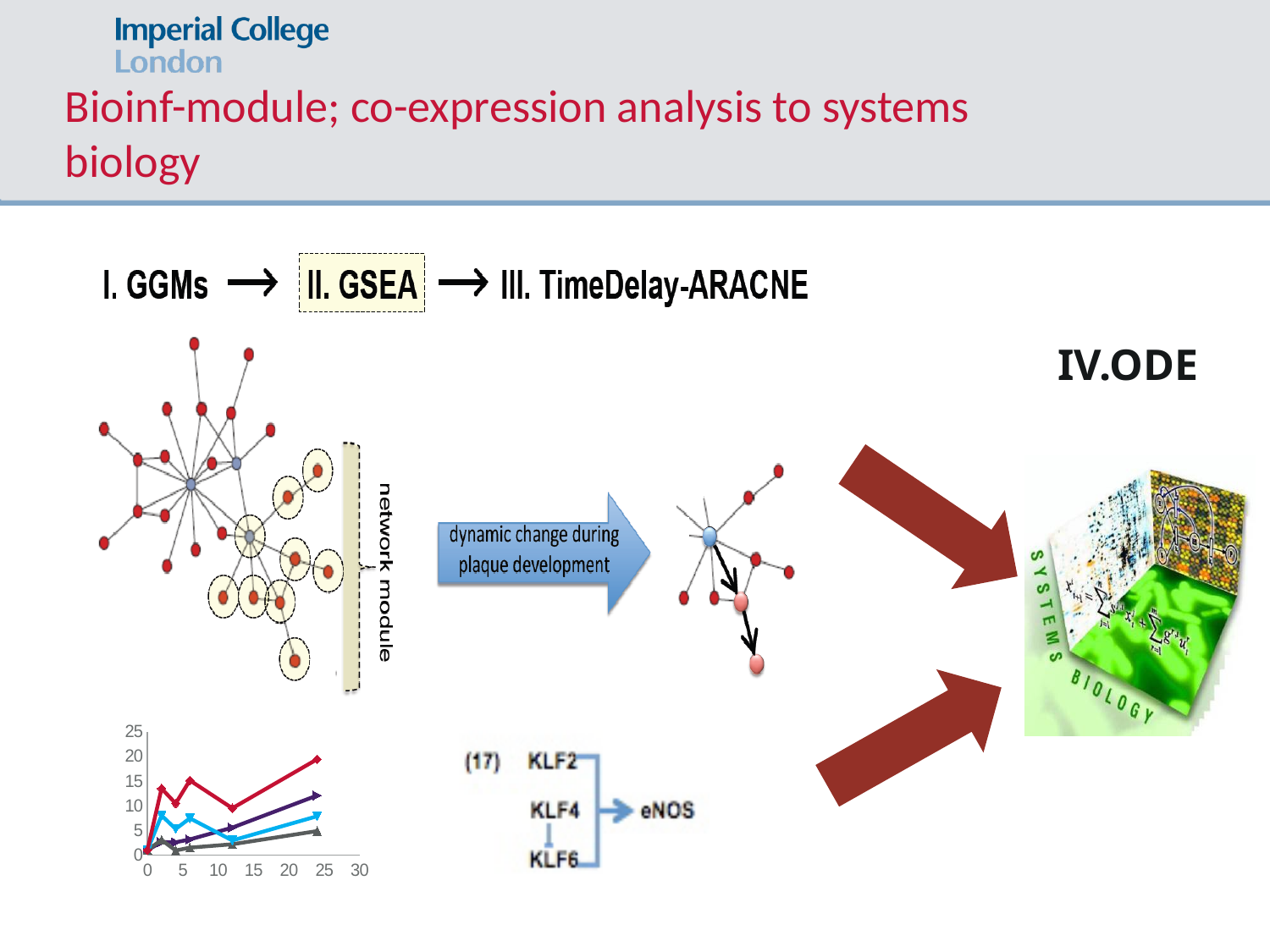
In the bottom-left line chart, is the final value of the purple line greater or less than 5? greater What is the highest tick value shown on the y axis of the bottom-left line chart? 25 In the bottom-left line chart, does the purple line rise or fall overall from left to right? rise What is the highest tick value shown on the x axis of the bottom-left line chart? 30 How many lines are plotted in the chart at the bottom left of the slide? 4 In the bottom-left line chart, is the final value of the red line greater or less than 15? greater In the bottom-left line chart, which coloured line is lowest at the right-hand end? gray In the bottom-left line chart, at the right-hand end, which is larger: the red line or the purple line? red In the bottom-left line chart, which coloured line reaches the highest value? red What kind of chart is shown at the bottom left of the slide? line chart In the bottom-left line chart, is the final value of the gray line greater or less than 10? less